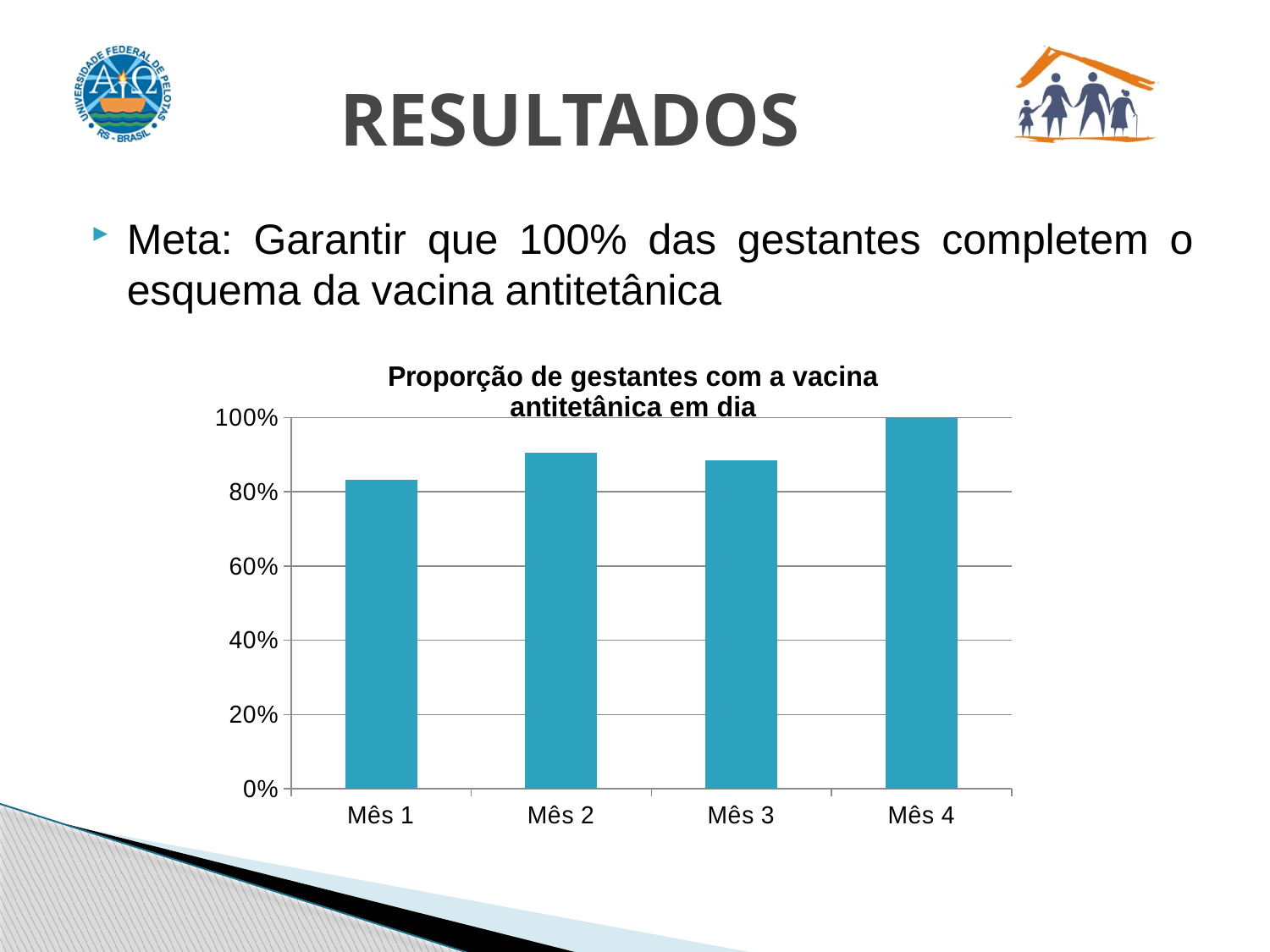
Is the value for Mês 3 greater or less than 80%? greater Which is larger, the value for Mês 1 or the value for Mês 4? Mês 4 Which month has the highest proportion of pregnant women with the tetanus vaccine up to date? Mês 4 What is the title of the chart? Proporção de gestantes com a vacina antitetânica em dia Is the value for Mês 1 greater or less than 80%? greater How many months (categories) are shown on the x axis of the chart? 4 Is the value for Mês 2 greater or less than 100%? less What is the value for Mês 4? 100% Which is larger, the value for Mês 1 or the value for Mês 2? Mês 2 What is the highest value shown on the y axis of the chart? 100% What kind of chart is shown on the slide? bar chart Which month has the lowest proportion of pregnant women with the tetanus vaccine up to date? Mês 1